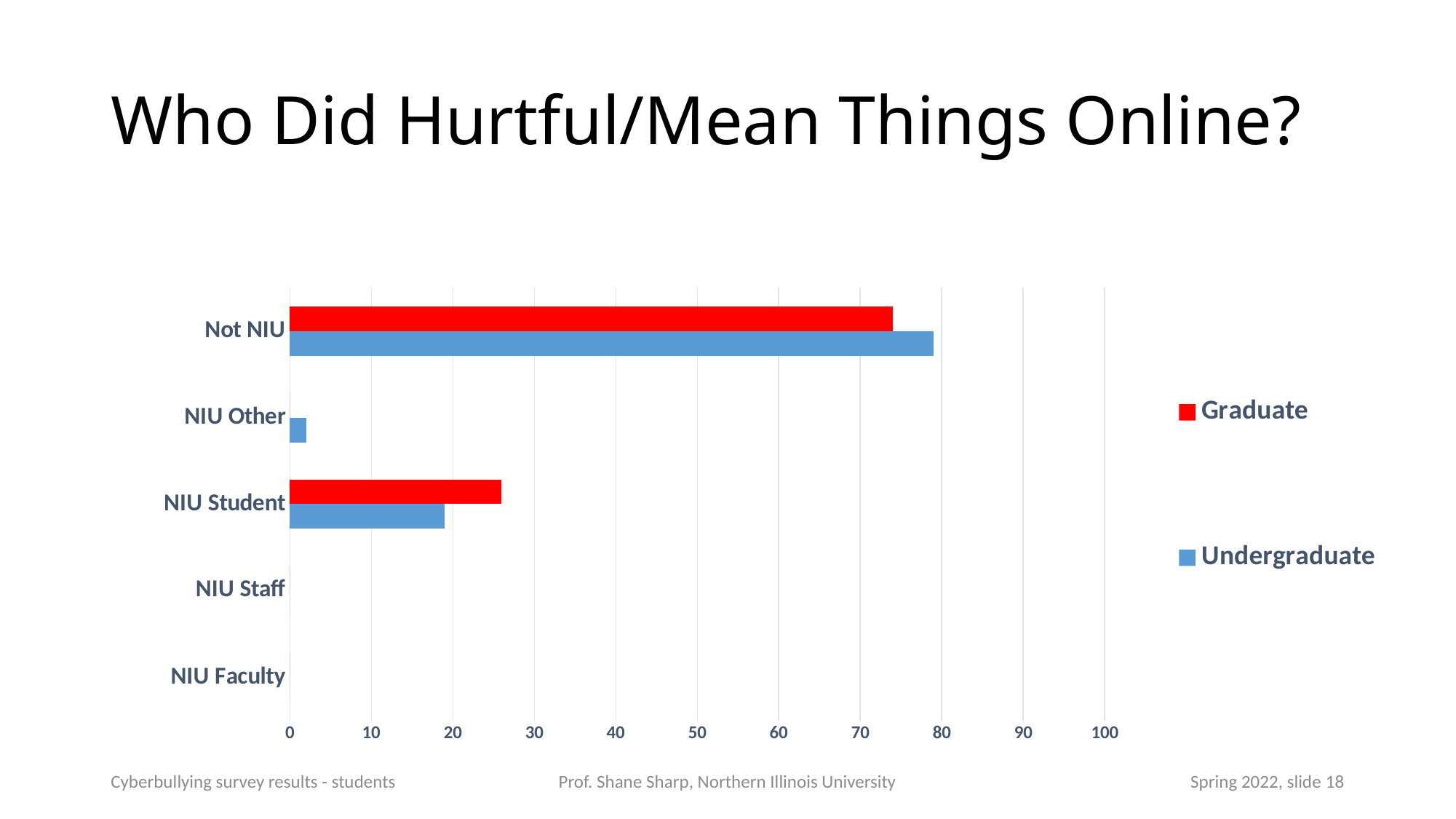
Which category has the highest Undergraduate value? Not NIU For Not NIU, which series has the larger value, Graduate or Undergraduate? Undergraduate Is the Undergraduate value for NIU Other greater or less than 10? less Which category has the highest Graduate value? Not NIU Is the Undergraduate value for NIU Student greater or less than 10? greater Is the Graduate value for NIU Student greater or less than 30? less How many categories are shown on the chart? 5 For NIU Student, which series has the larger value, Graduate or Undergraduate? Graduate How many series does the legend list? 2 What colour represents the Graduate series in the legend? red What kind of chart is shown on the slide? bar chart